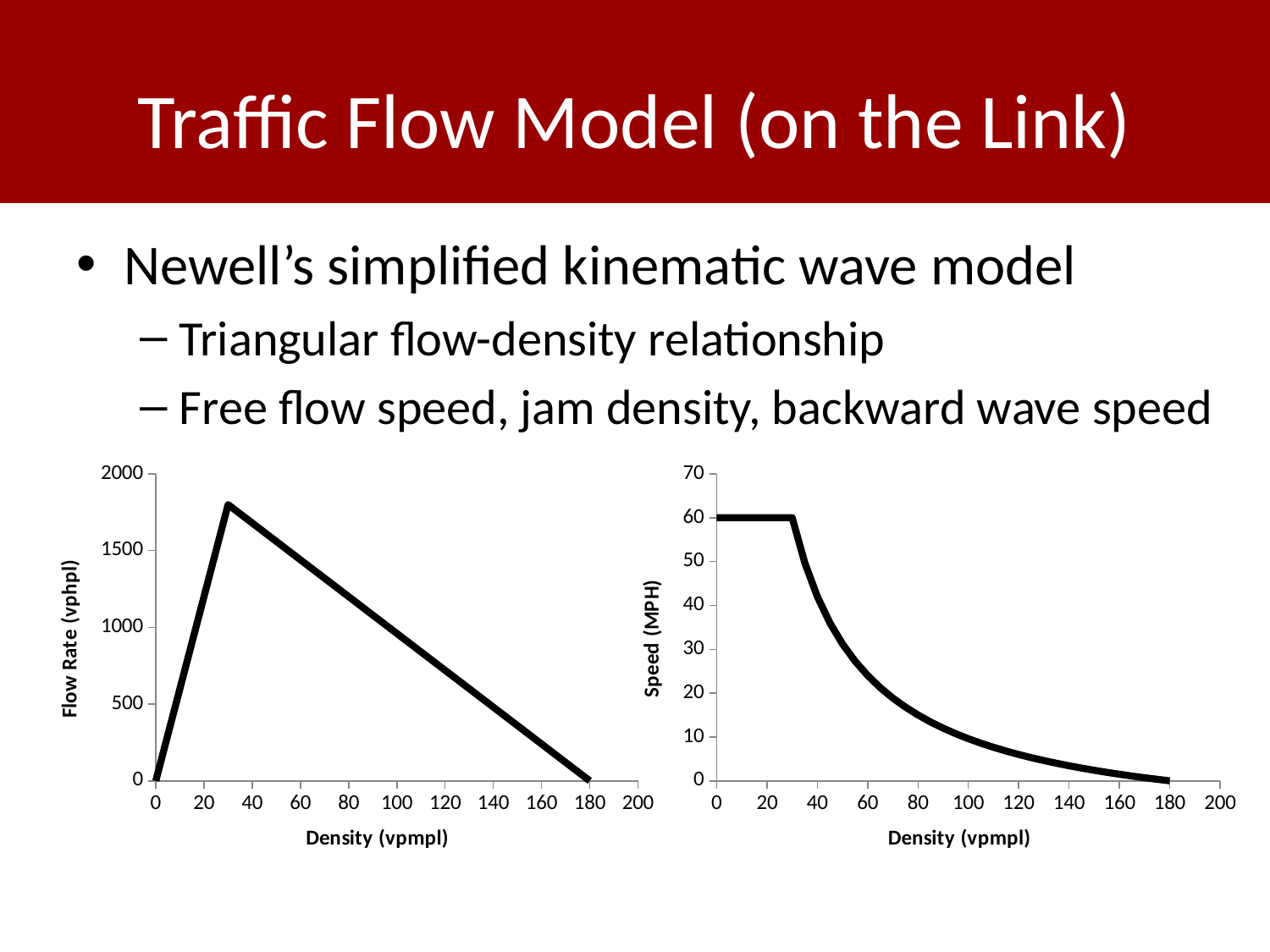
On the left chart, what is the label of the y axis? Flow Rate (vphpl) On the right chart, what is the speed at a density of 180? 0 On the right chart, what is the speed at a density of 0? 60 On the left chart, what is the flow rate at a density of 180? 0 On the left chart, is the flow rate at a density of 100 greater or less than 1500? less On the left chart, is the peak flow rate greater or less than 1500? greater On the right chart, what is the label of the x axis? Density (vpmpl) What kind of chart is the left chart (Flow Rate vs Density)? line chart On the right chart, is the speed at a density of 100 greater or less than 20? less On the right chart, does the speed rise or fall as density increases beyond 40? fall What kind of chart is the right chart (Speed vs Density)? line chart On the left chart, is the flow rate at a density of 40 larger or smaller than at a density of 160? larger